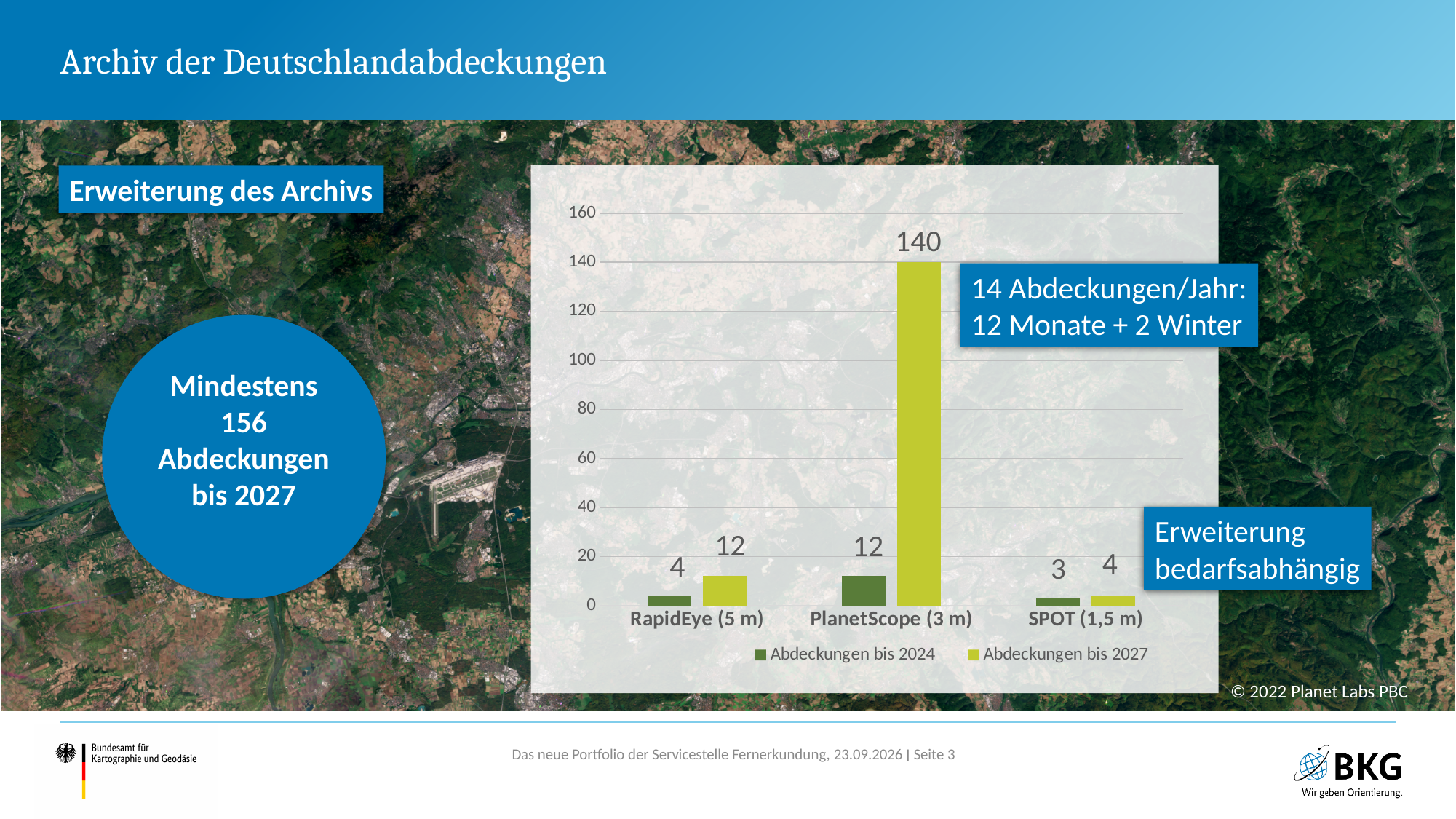
What is the difference between Abdeckungen bis 2027 and Abdeckungen bis 2024 for PlanetScope (3 m)? 128 What kind of chart is shown on the slide? bar chart Which category has the highest value for Abdeckungen bis 2027? PlanetScope (3 m) Which category has the lowest value for Abdeckungen bis 2024? SPOT (1,5 m) What is the value of Abdeckungen bis 2024 for SPOT (1,5 m)? 3 How many series does the chart legend list? 2 Is the value of Abdeckungen bis 2027 for PlanetScope (3 m) greater or less than 120? greater What is the value of Abdeckungen bis 2027 for PlanetScope (3 m)? 140 How many categories are shown on the x axis of the chart? 3 What is the value of Abdeckungen bis 2027 for RapidEye (5 m)? 12 What is the value of Abdeckungen bis 2024 for RapidEye (5 m)? 4 Which is larger: Abdeckungen bis 2027 for RapidEye (5 m) or Abdeckungen bis 2027 for SPOT (1,5 m)? RapidEye (5 m)